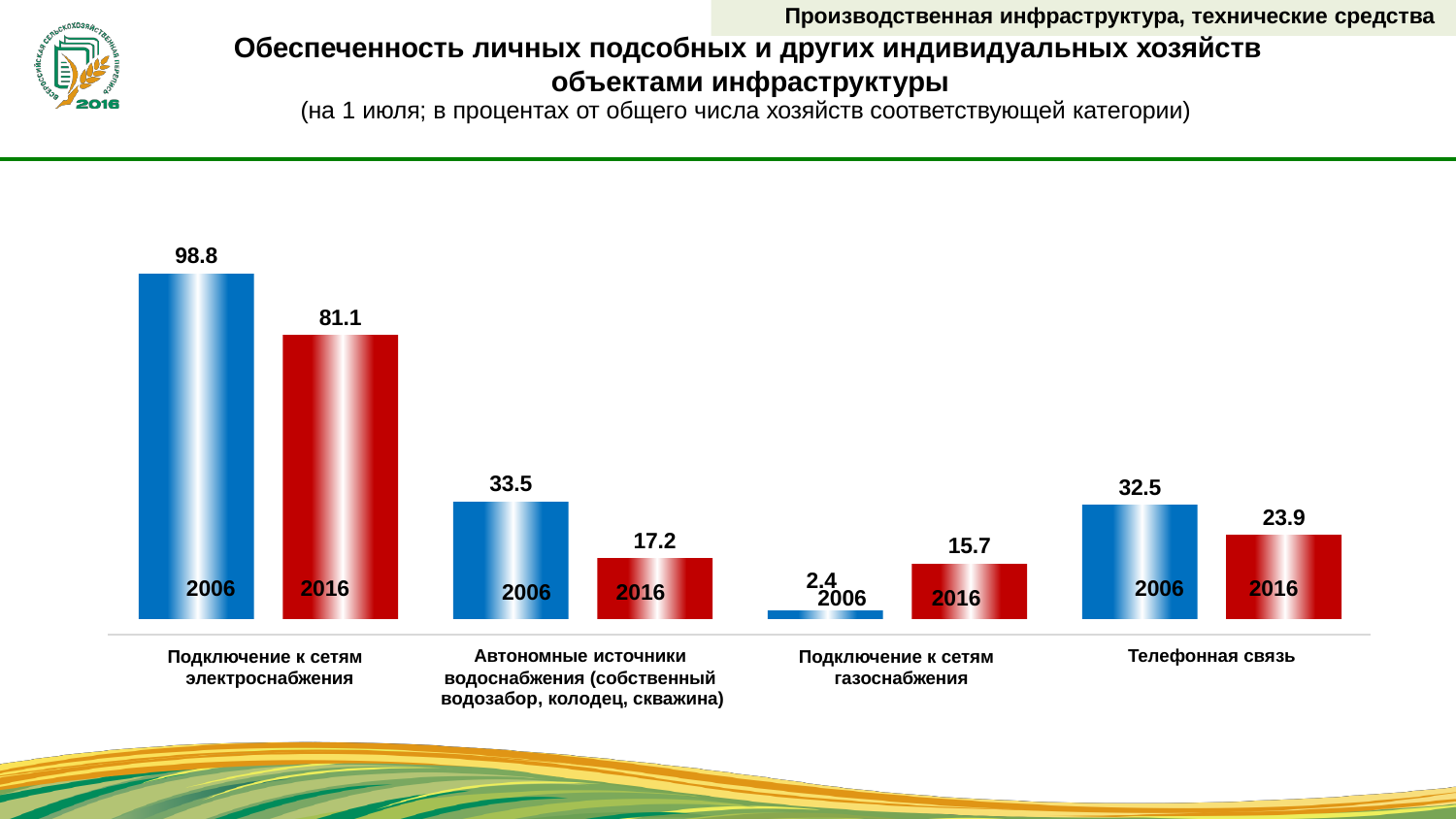
Which is larger for "Подключение к сетям газоснабжения": the 2006 value or the 2016 value? 2016 What is the value for 2016 in the category "Подключение к сетям электроснабжения"? 81.1 Which is larger for "Телефонная связь": the 2006 value or the 2016 value? 2006 Which colour represents the 2016 bars in the chart? Red What is the difference between the 2006 and 2016 values for "Автономные источники водоснабжения (собственный водозабор, колодец, скважина)"? 16.3 What is the value for 2016 in the category "Подключение к сетям газоснабжения"? 15.7 Which category has the lowest 2006 value? Подключение к сетям газоснабжения How many categories are shown on the x axis of the chart? 4 Which category has the highest 2006 value? Подключение к сетям электроснабжения What is the value for 2006 in the category "Телефонная связь"? 32.5 What kind of chart is shown on the slide? Bar chart What is the value for 2006 in the category "Подключение к сетям электроснабжения"? 98.8